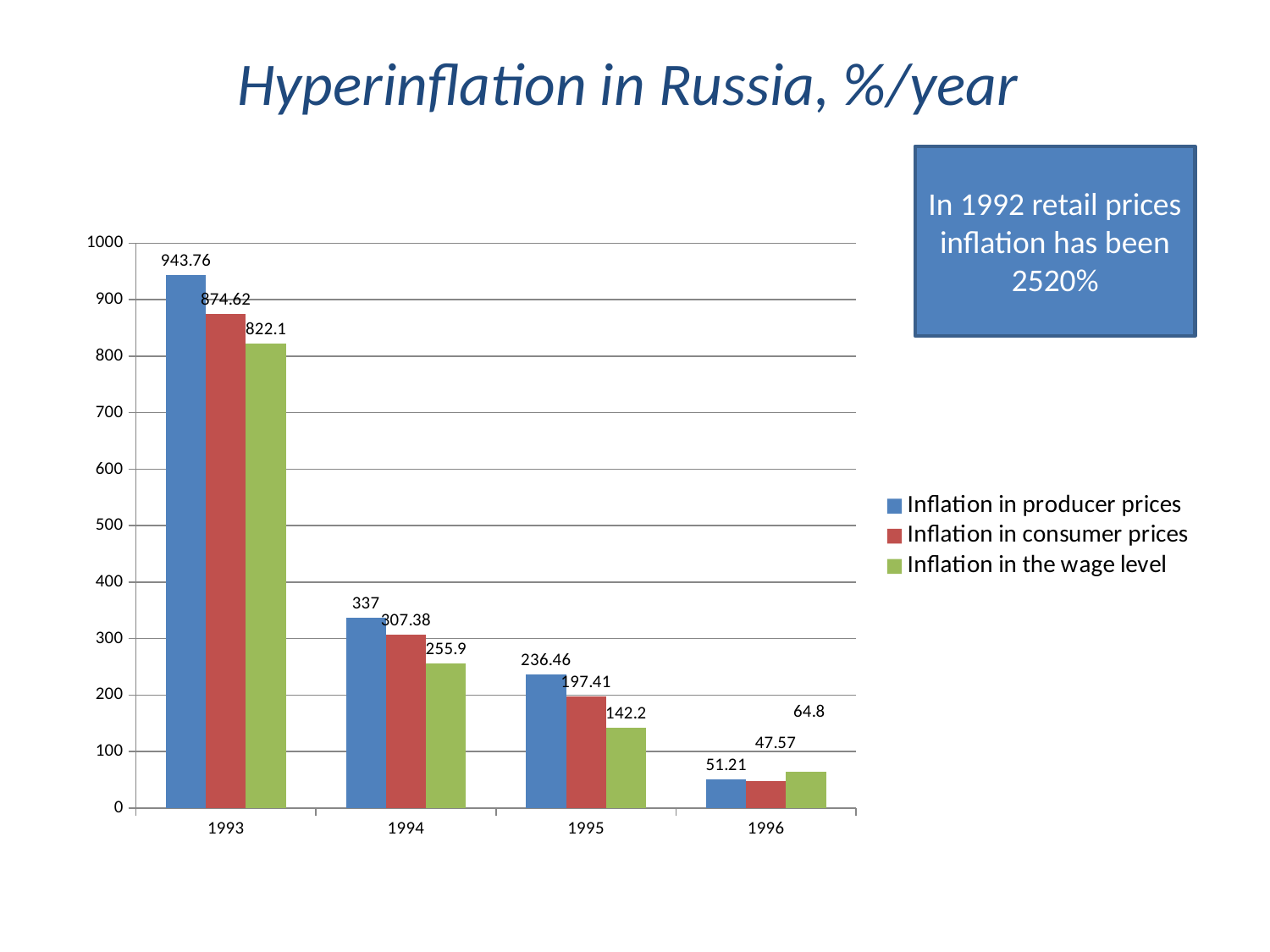
In 1996, which is larger: Inflation in producer prices or Inflation in the wage level? Inflation in the wage level In which year is Inflation in producer prices highest? 1993 Does Inflation in consumer prices rise or fall from 1993 to 1996? Fall How many series does the legend list? 3 What is the value for Inflation in the wage level in 1996? 64.8 What is the difference between Inflation in producer prices and Inflation in consumer prices in 1994? 29.62 What is the value for Inflation in consumer prices in 1995? 197.41 What kind of chart is shown on the slide? Bar chart In which year is Inflation in consumer prices lowest? 1996 What is the value for Inflation in producer prices in 1993? 943.76 Is the value for Inflation in the wage level in 1993 greater or less than 800? greater How many years are shown on the x axis? 4